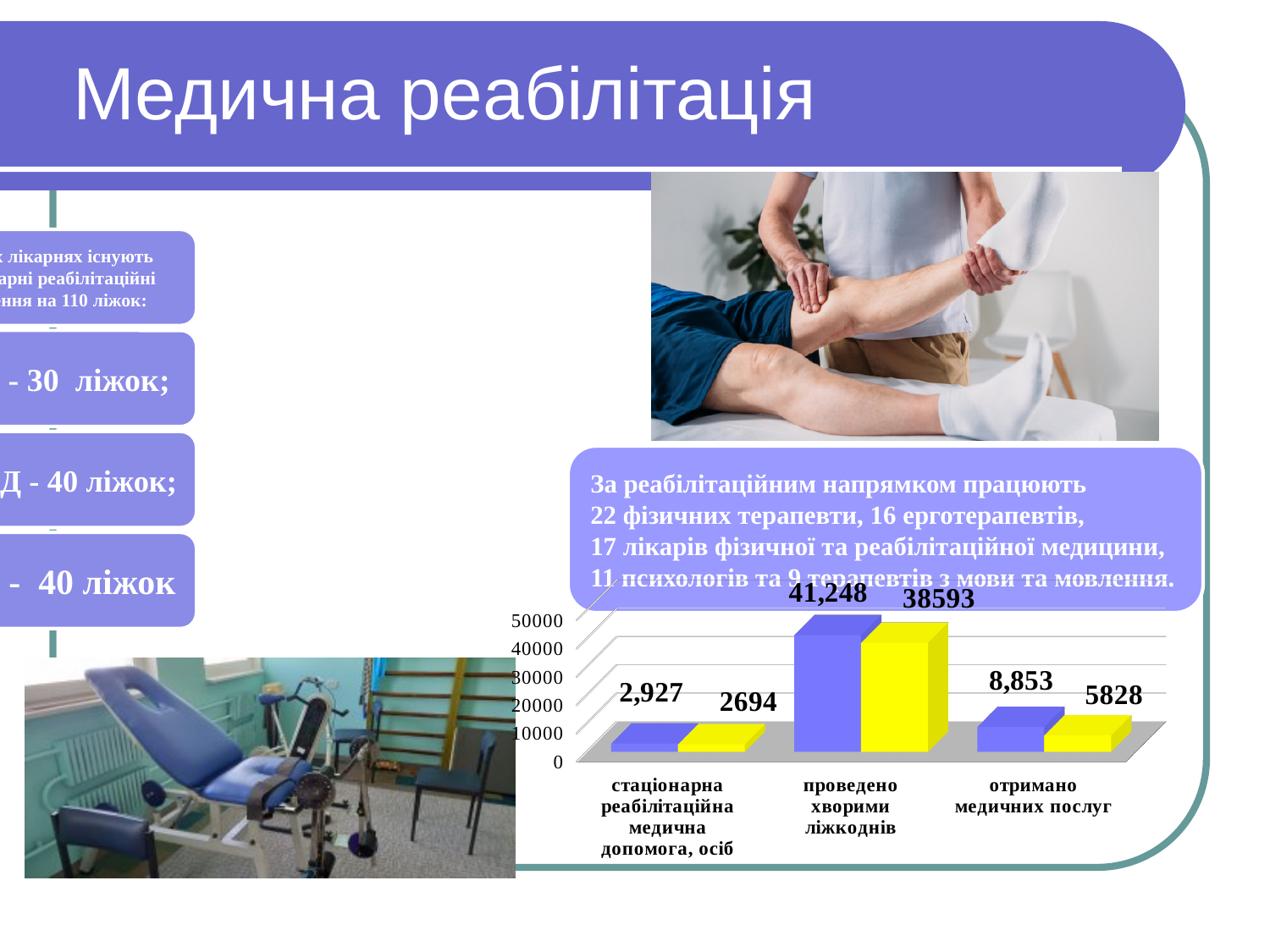
What is the value of the yellow bar for "отримано медичних послуг"? 5828 Which is larger for "отримано медичних послуг": the blue bar or the yellow bar? the blue bar What is the difference between the blue and yellow bars for "отримано медичних послуг"? 3025 Which category has the lowest yellow bar? стаціонарна реабілітаційна медична допомога, осіб How many categories are shown on the x axis of the chart? 3 Which category has the highest blue bar? проведено хворими ліжкоднів What is the difference between the blue and yellow bars for "проведено хворими ліжкоднів"? 2655 What kind of chart is shown on the slide? bar chart What is the highest tick value shown on the vertical axis of the chart? 50000 What is the value of the blue bar for "проведено хворими ліжкоднів"? 41,248 What is the value of the yellow bar for "проведено хворими ліжкоднів"? 38593 What is the value of the blue bar for "стаціонарна реабілітаційна медична допомога, осіб"? 2,927